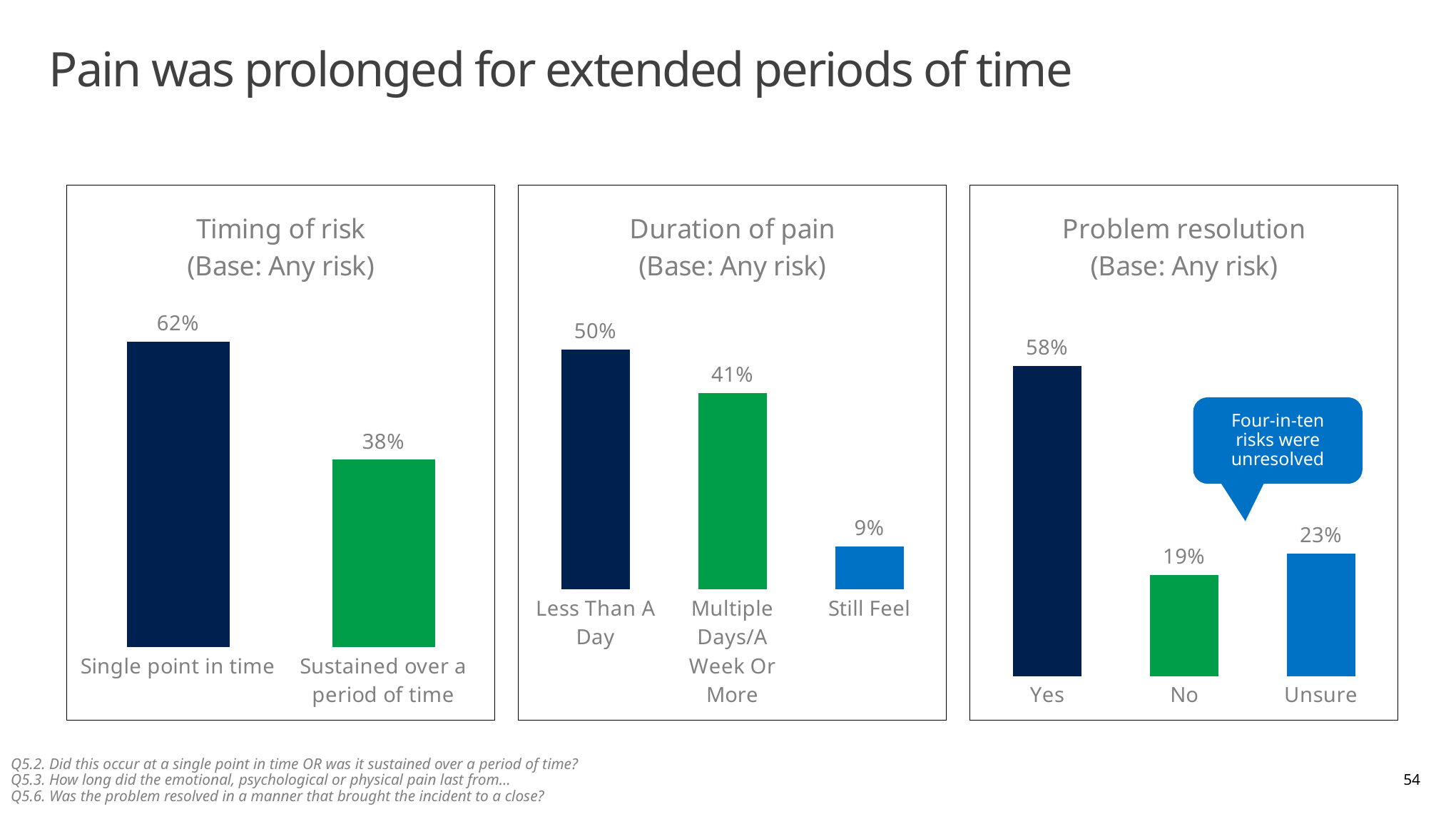
In the 'Problem resolution' chart, what does the callout box say? Four-in-ten risks were unresolved In the 'Timing of risk' chart, what is the difference between 'Single point in time' and 'Sustained over a period of time'? 24% In the 'Problem resolution' chart, what is the difference between 'Yes' and 'No'? 39% In the 'Duration of pain' chart, what is the value for 'Multiple Days/A Week Or More'? 41% In the 'Problem resolution' chart, which is larger, 'No' or 'Unsure'? Unsure In the 'Timing of risk' chart, what is the value for 'Sustained over a period of time'? 38% In the 'Duration of pain' chart, which category has the highest value? Less Than A Day In the 'Problem resolution' chart, what is the value for 'Yes'? 58% In the 'Timing of risk' chart, what is the value for 'Single point in time'? 62% In the 'Duration of pain' chart, how many categories are shown? 3 In the 'Duration of pain' chart, which category has the lowest value? Still Feel What type of chart is the 'Timing of risk' chart? Bar chart